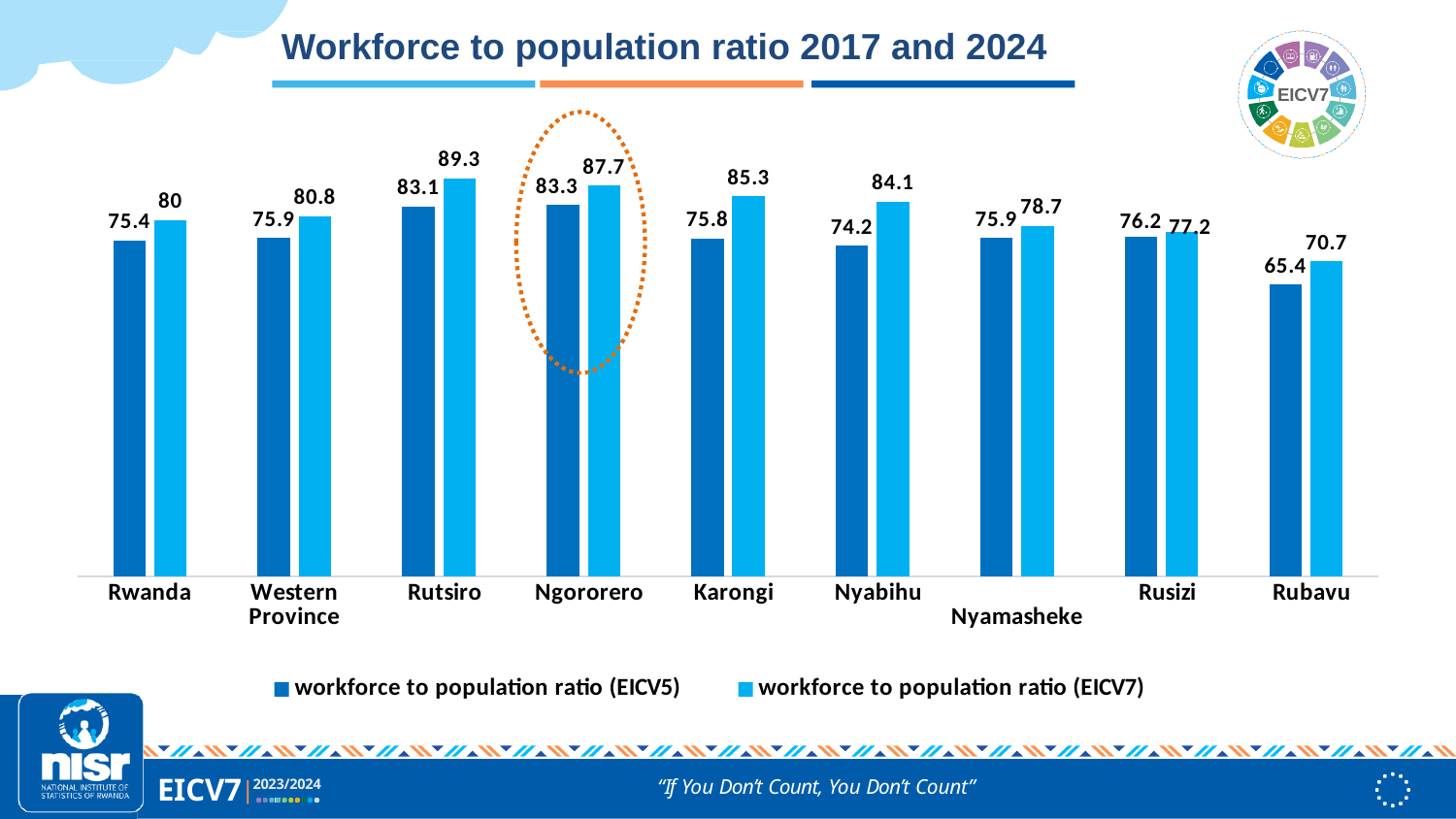
Which is larger, the EICV7 workforce to population ratio for Ngororero or for Karongi? Ngororero What is the difference between the EICV7 and EICV5 workforce to population ratios for Karongi? 9.5 How many categories are shown on the x axis of the chart? 9 Which category has the lowest workforce to population ratio (EICV5)? Rubavu How many series does the legend list? 2 What is the workforce to population ratio (EICV5) for Rubavu? 65.4 What is the workforce to population ratio (EICV7) for Nyabihu? 84.1 What is the workforce to population ratio (EICV5) for Rwanda? 75.4 What is the difference between the EICV7 and EICV5 workforce to population ratios for Rubavu? 5.3 Which category has the highest workforce to population ratio (EICV7)? Rutsiro What kind of chart is shown on the slide? Bar chart What is the workforce to population ratio (EICV7) for Rutsiro? 89.3